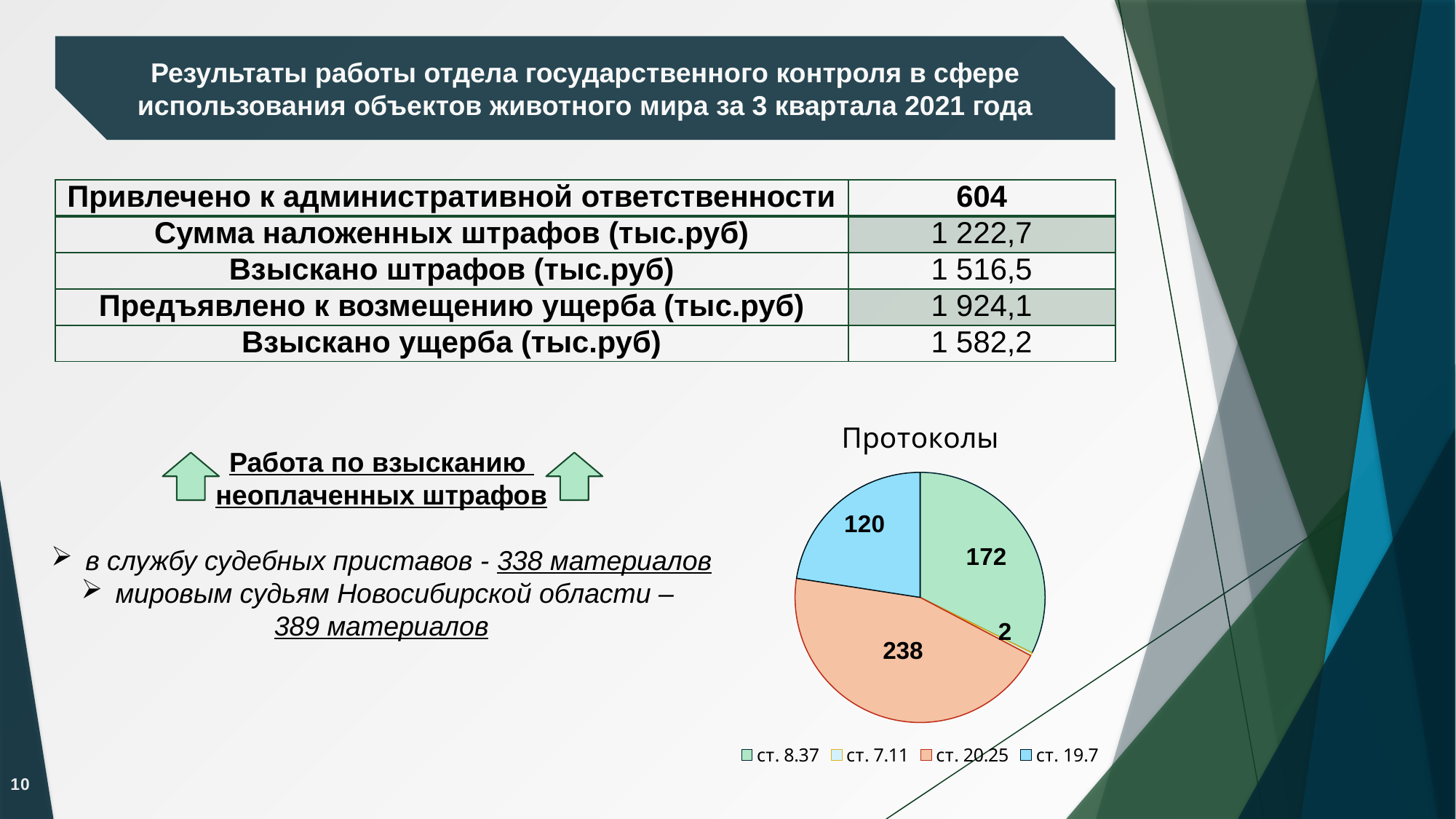
Which category has the largest slice in the "Протоколы" pie chart? ст. 20.25 How many categories does the legend of the "Протоколы" pie chart list? 4 What is the total of all slices in the "Протоколы" pie chart? 532 In the "Протоколы" pie chart, what is the value for ст. 8.37? 172 In the "Протоколы" pie chart, what is the difference between the values for ст. 8.37 and ст. 19.7? 52 Which category has the smallest slice in the "Протоколы" pie chart? ст. 7.11 In the "Протоколы" pie chart, what is the value for ст. 19.7? 120 In the "Протоколы" pie chart, what is the difference between the values for ст. 20.25 and ст. 8.37? 66 In the "Протоколы" pie chart, which is larger: ст. 8.37 or ст. 19.7? ст. 8.37 In the "Протоколы" pie chart, what is the value for ст. 20.25? 238 In the "Протоколы" pie chart, what is the value for ст. 7.11? 2 What kind of chart is the "Протоколы" chart? pie chart